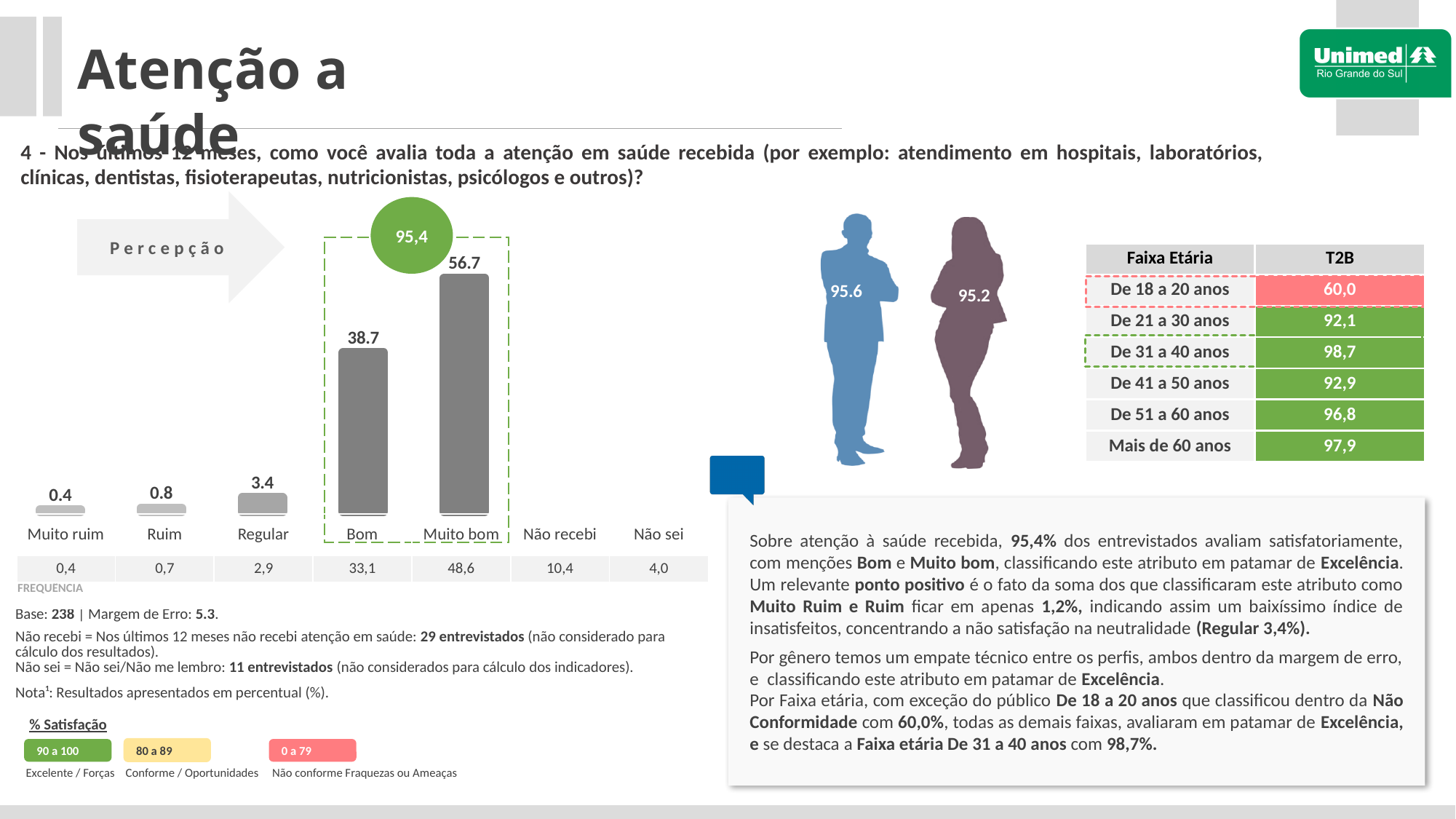
In the Faixa Etária table, what is the T2B value for De 18 a 20 anos? 60,0 In the bar chart, what is the value for Muito bom? 56.7 In the bar chart, which category has the highest value? Muito bom In the Faixa Etária table, which age group has the highest T2B value? De 31 a 40 anos What kind of chart is shown on the left of the slide? bar chart What value is shown in the green circle above the Bom and Muito bom bars? 95,4 In the bar chart, what is the difference between the values for Muito bom and Bom? 18.0 How many category labels are shown along the x axis of the bar chart? 7 In the bar chart, what is the value for Bom? 38.7 In the bar chart, what is the value for Regular? 3.4 In the bar chart, which is larger, the value for Ruim or the value for Regular? Regular In the bar chart, which category has the lowest plotted value? Muito ruim